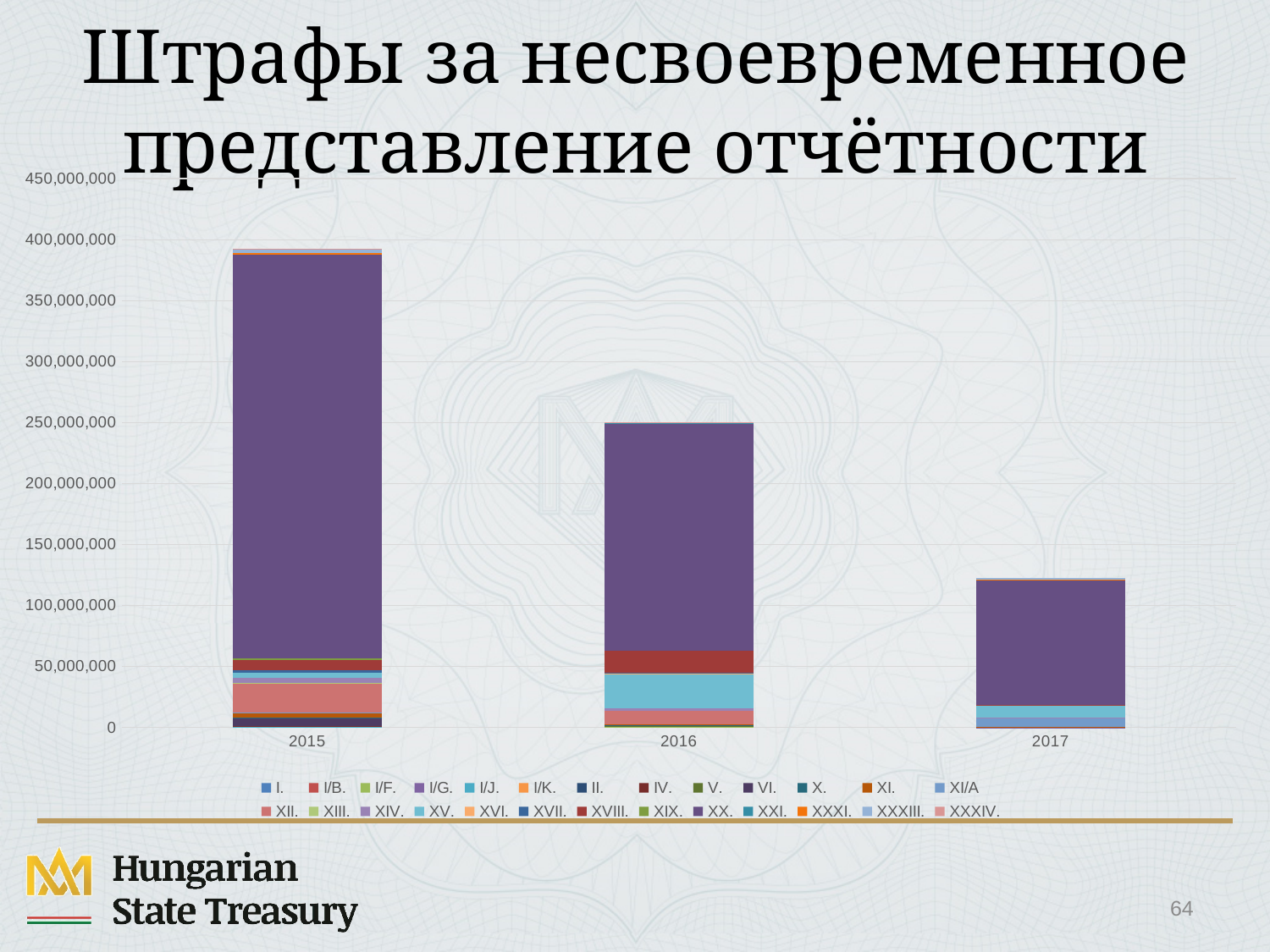
How many series does the legend list? 26 Is the total for 2017 greater or less than 150,000,000? less Which year has the tallest stacked bar? 2015 How many years are shown on the x axis of the chart? 3 What is the highest value shown on the y axis? 450,000,000 Is the total for 2016 greater or less than 300,000,000? less What kind of chart is shown on the slide? stacked bar chart Is the total for 2015 greater or less than 350,000,000? greater Which year has the shortest stacked bar? 2017 Do the total bar heights rise or fall from 2015 to 2017? fall Which year has a larger total, 2015 or 2016? 2015